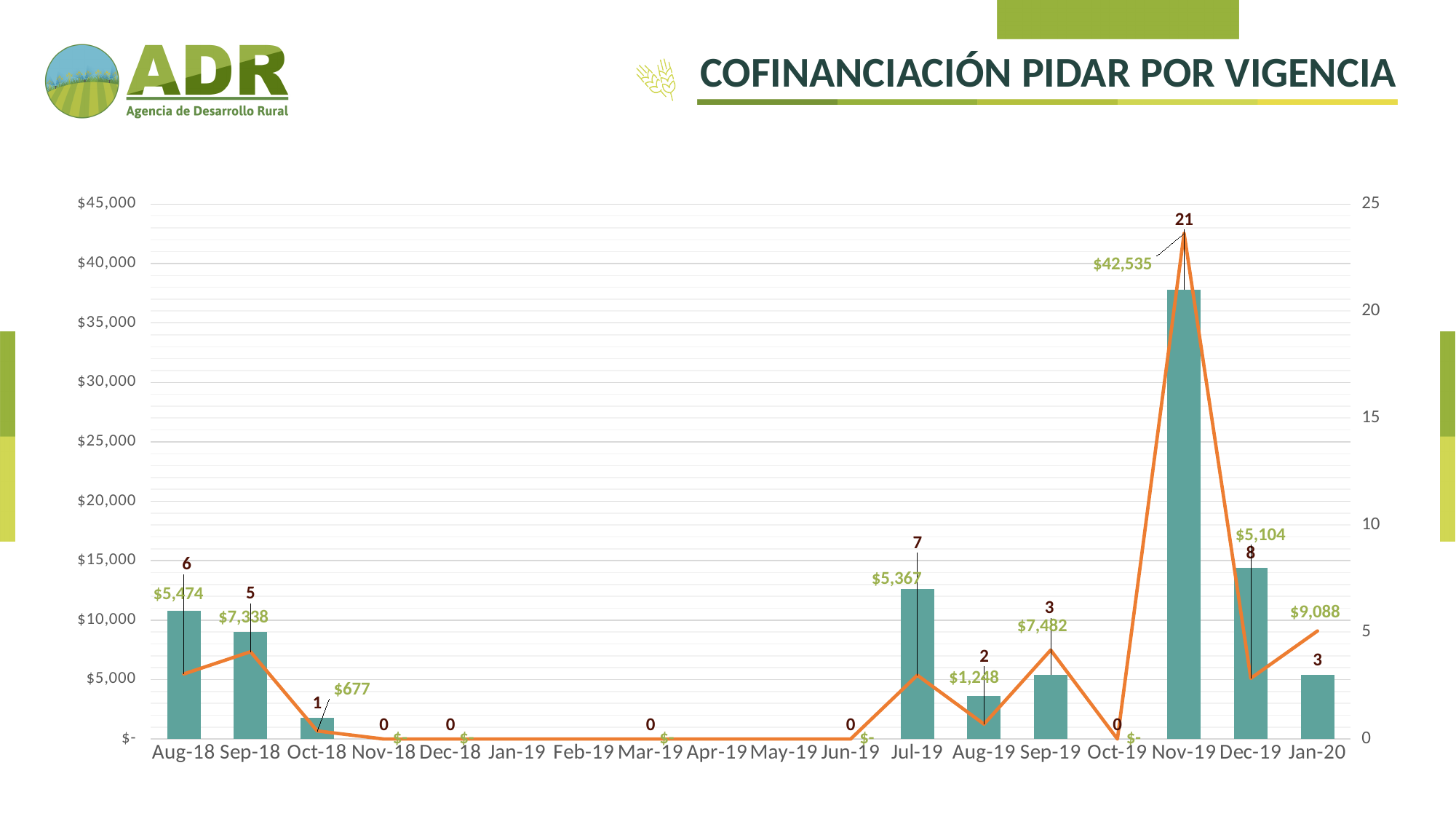
What is the difference between the bar values for Nov-19 and Dec-19? 13 Which has the larger dollar value, Aug-18 or Sep-18? Sep-18 Do the dollar values on the line rise or fall from Sep-18 to Nov-18? Fall What is the dollar value labelled on the line for Nov-19? $42,535 What is the value labelled on the bar for Nov-19? 21 What is the value labelled on the bar for Dec-19? 8 What is the dollar value labelled for Jan-20? $9,088 Which month has the highest dollar value on the line? Nov-19 What kind of chart is shown on the slide? Combination bar and line chart What is the title of the slide? COFINANCIACIÓN PIDAR POR VIGENCIA How many months are shown on the x axis? 18 What is the difference between the dollar values for Sep-19 and Aug-19? $6,234